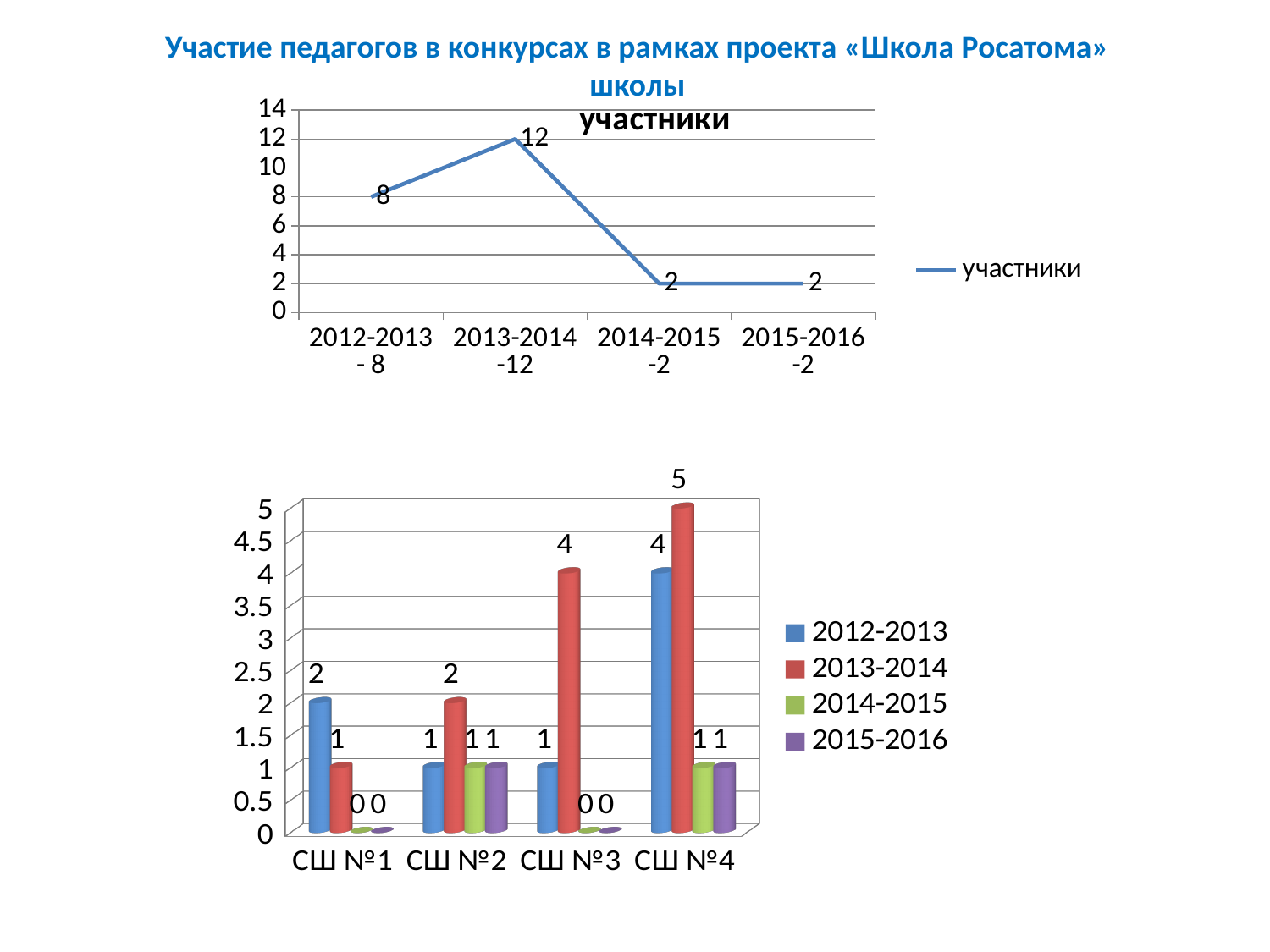
In the top line chart titled «участники», which period has the highest value? 2013-2014 In the bottom bar chart, which is larger for СШ №1: the 2012-2013 value or the 2013-2014 value? 2012-2013 In the top line chart titled «участники», what is the value for 2012-2013? 8 In the top line chart titled «участники», do the values rise or fall from 2013-2014 to 2014-2015? fall In the bottom bar chart, which school has the highest value in the 2012-2013 series? СШ №4 In the bottom bar chart, what is the value for СШ №4 in the 2013-2014 series? 5 In the top line chart titled «участники», what is the value for 2013-2014? 12 In the top line chart titled «участники», what is the difference between the values for 2013-2014 and 2014-2015? 10 In the top line chart titled «участники», how many data points are plotted? 4 In the bottom bar chart, how many series does the legend list? 4 In the bottom bar chart, what is the value for СШ №3 in the 2013-2014 series? 4 What kind of chart is the bottom chart on the slide? bar chart